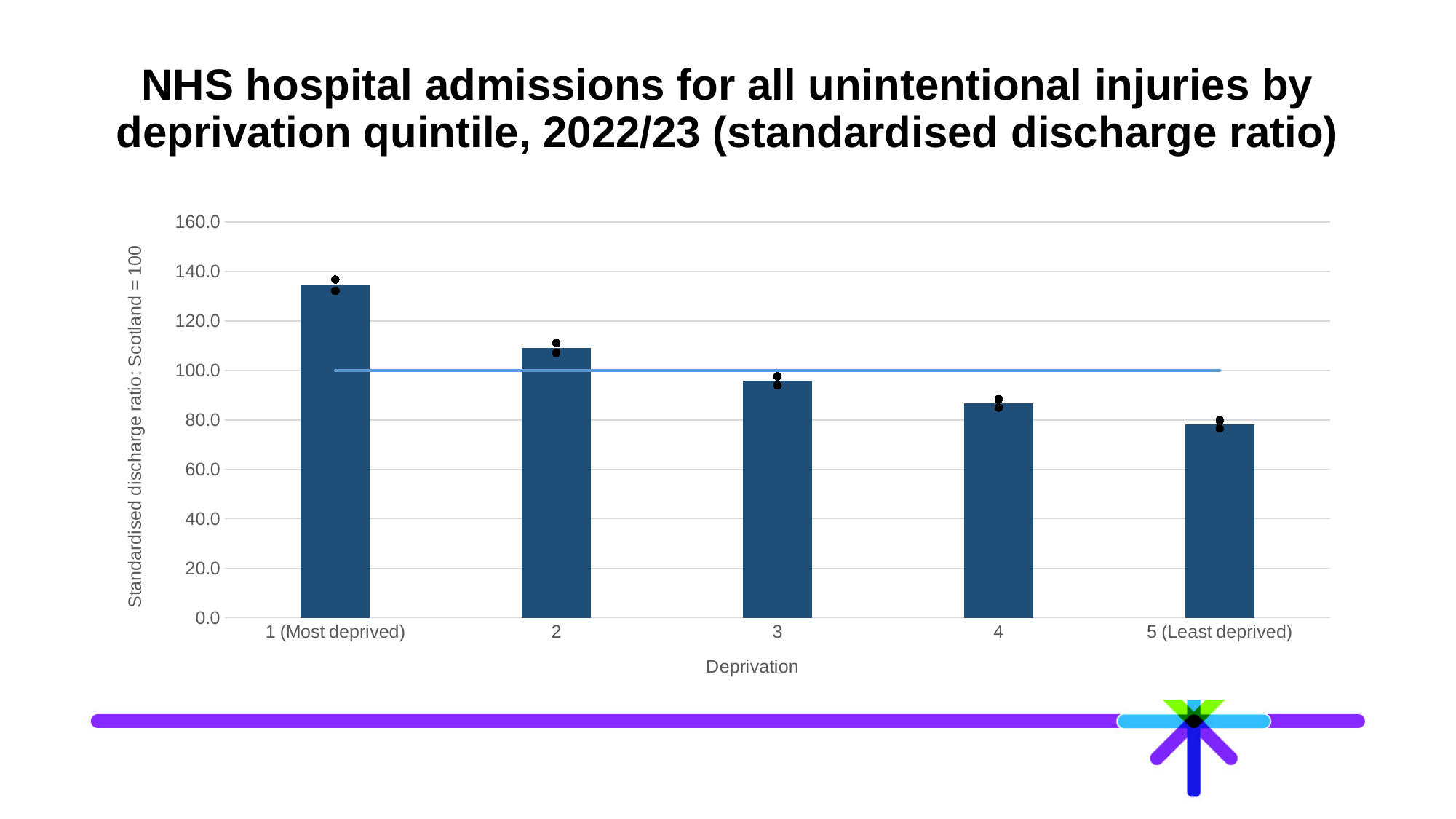
At what value is the horizontal reference line drawn across the chart? 100.0 Is the standardised discharge ratio for quintile 1 (Most deprived) greater or less than 120.0? greater What kind of chart is shown on the slide? bar chart Is the standardised discharge ratio for quintile 2 greater or less than 100.0? greater Do the bar values rise or fall moving from quintile 1 (Most deprived) to quintile 5 (Least deprived)? fall What is the label of the y axis? Standardised discharge ratio: Scotland = 100 Which deprivation quintile has the highest standardised discharge ratio? 1 (Most deprived) Which has a higher standardised discharge ratio, quintile 2 or quintile 4? 2 How many deprivation quintile categories are plotted on the x axis? 5 Which deprivation quintile has the lowest standardised discharge ratio? 5 (Least deprived) Is the standardised discharge ratio for quintile 4 greater or less than 100.0? less